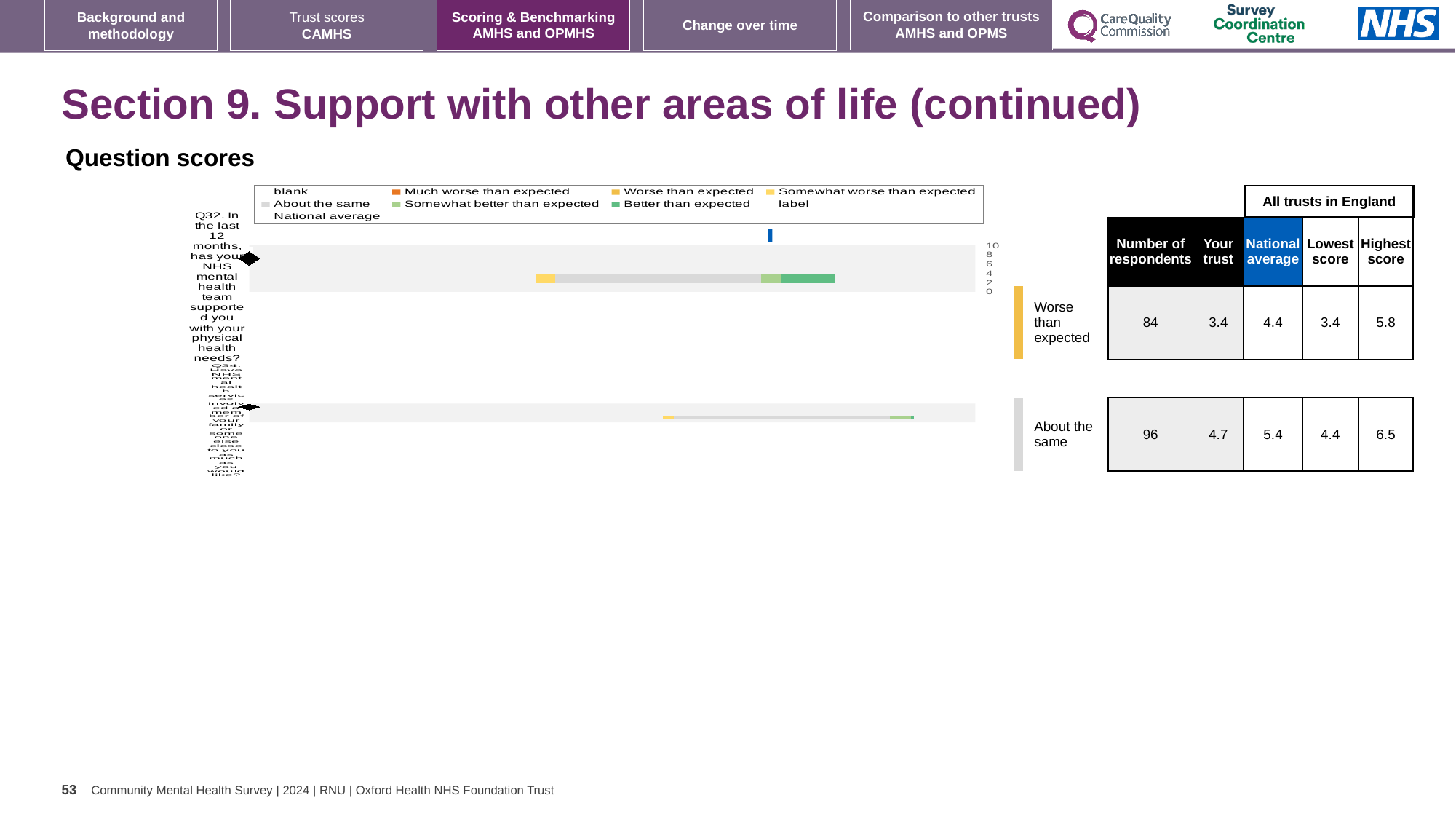
Which question has more respondents, Q32 or Q34? Q34 How many respondents answered Q32? 84 What kind of chart is used to show the question scores on this slide? bar chart What is the highest score across all trusts in England for Q32? 5.8 What is the lowest score across all trusts in England for Q34? 4.4 How many survey questions are plotted in the question scores chart? 2 What is the national average score for Q32? 4.4 What is the 'Your trust' score for Q34 (involving family or someone close)? 4.7 What is the difference between the national average and the 'Your trust' score for Q34? 0.7 What is the benchmark category shown for Q34? About the same What is the 'Your trust' score for Q32 (support with physical health needs)? 3.4 What is the benchmark category shown for Q32? Worse than expected